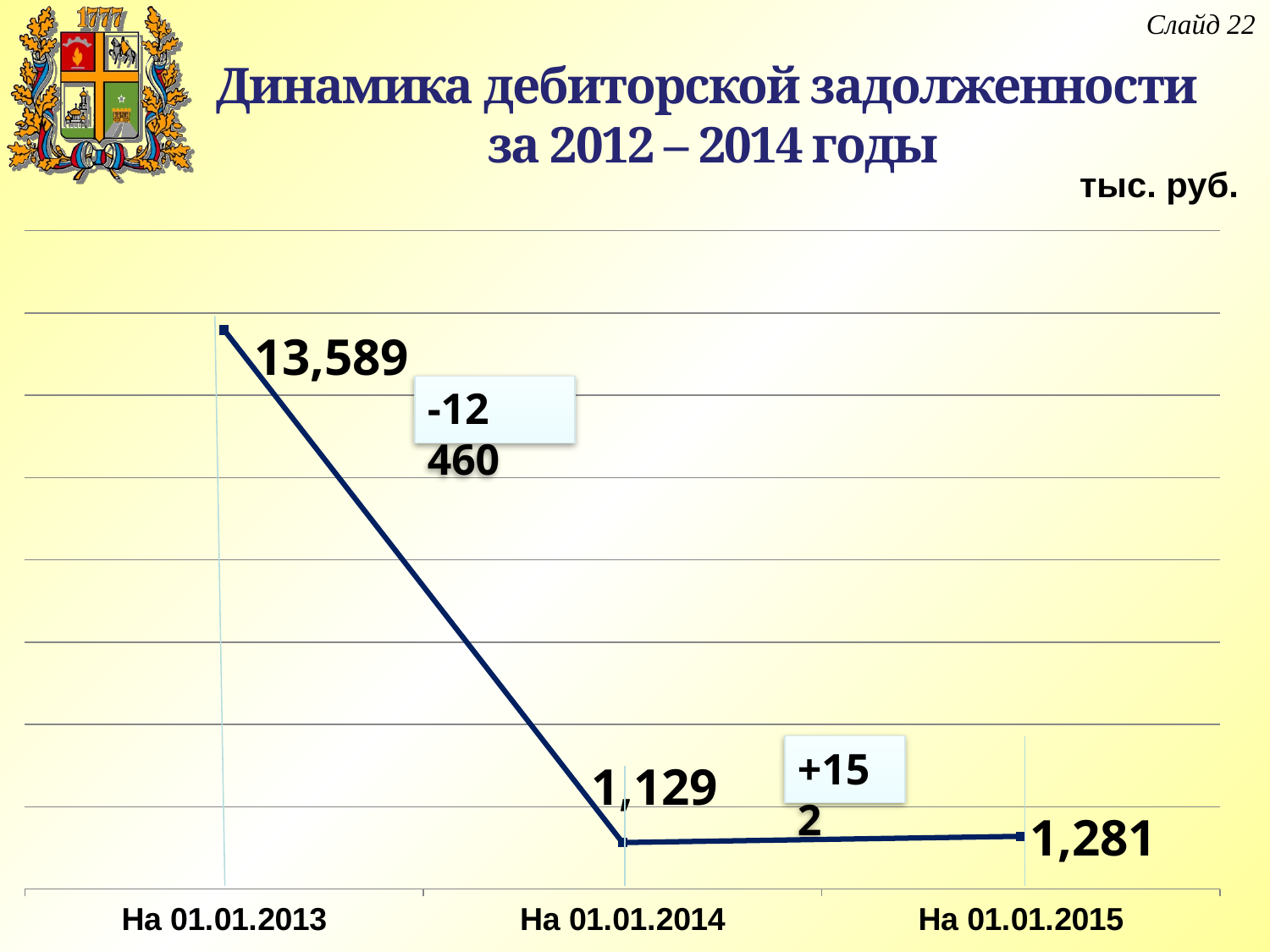
What is the difference between the values for На 01.01.2015 and На 01.01.2014? 152 What is the value for На 01.01.2015? 1,281 Which date has the lowest value? На 01.01.2014 How many data points are plotted on the chart? 3 What unit of measurement is indicated on the slide for the chart values? тыс. руб. What kind of chart is shown on the slide? Line chart Does the value rise or fall from На 01.01.2013 to На 01.01.2014? Fall What is the value for На 01.01.2013? 13,589 Which date has the highest value? На 01.01.2013 What is the difference between the values for На 01.01.2013 and На 01.01.2014? 12,460 Which is larger, the value for На 01.01.2014 or the value for На 01.01.2015? На 01.01.2015 What is the value for На 01.01.2014? 1,129